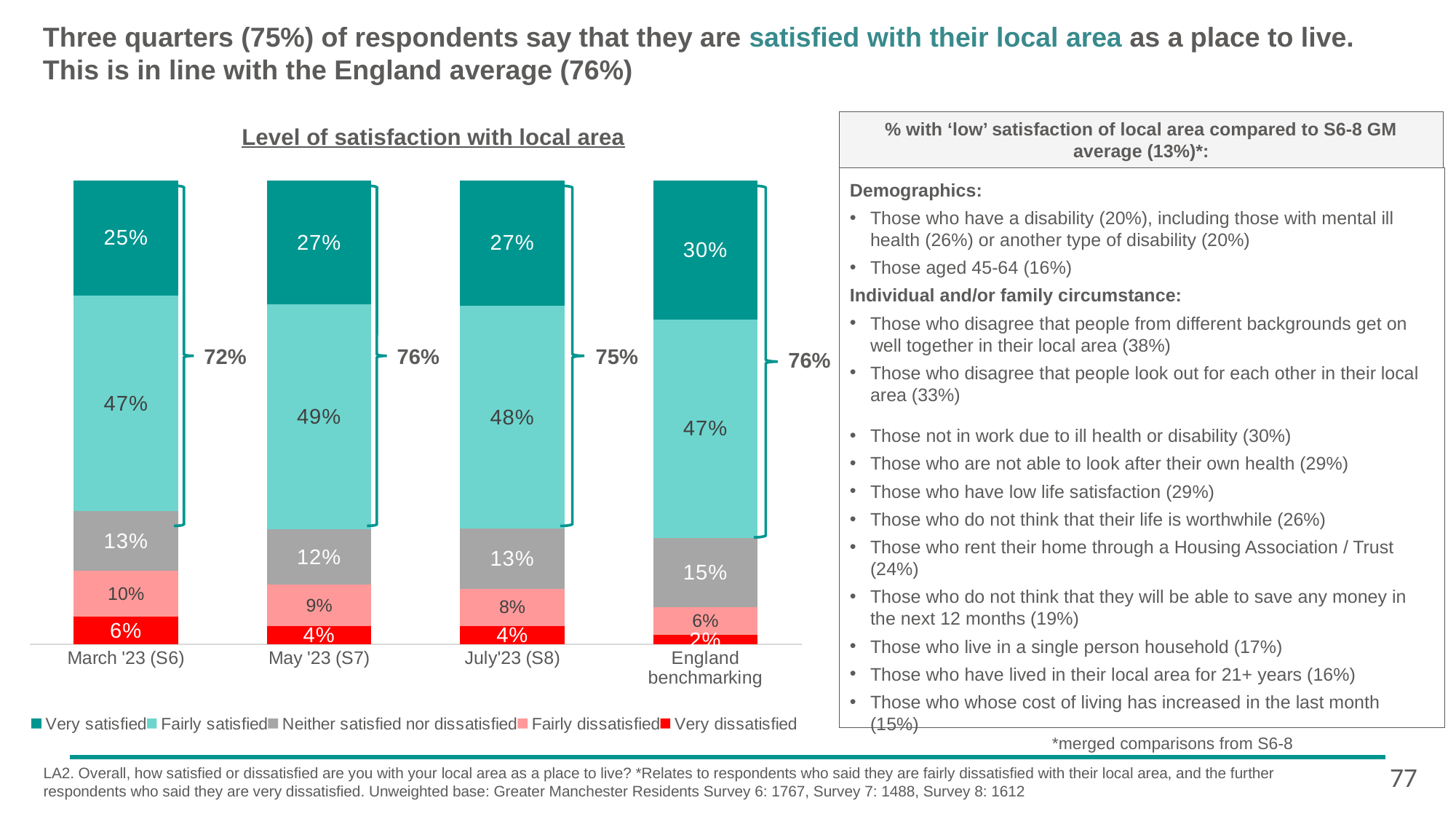
What combined satisfied percentage is shown by the bracket for March '23 (S6)? 72% Which bar has the lowest 'Very dissatisfied' percentage? England benchmarking How many series does the legend list? 5 Which bar has the highest 'Very satisfied' percentage? England benchmarking What is the difference in 'Fairly satisfied' between May '23 (S7) and March '23 (S6)? 2 percentage points Which has a larger 'Fairly dissatisfied' share, March '23 (S6) or July'23 (S8)? March '23 (S6) What is the 'Neither satisfied nor dissatisfied' value for England benchmarking? 15% What percentage were 'Very dissatisfied' in March '23 (S6)? 6% What is the 'Fairly satisfied' value for May '23 (S7)? 49% What type of chart is used to show the level of satisfaction with local area? Stacked bar chart How many bars are shown in the chart? 4 What percentage of respondents were 'Very satisfied' in the England benchmarking bar? 30%